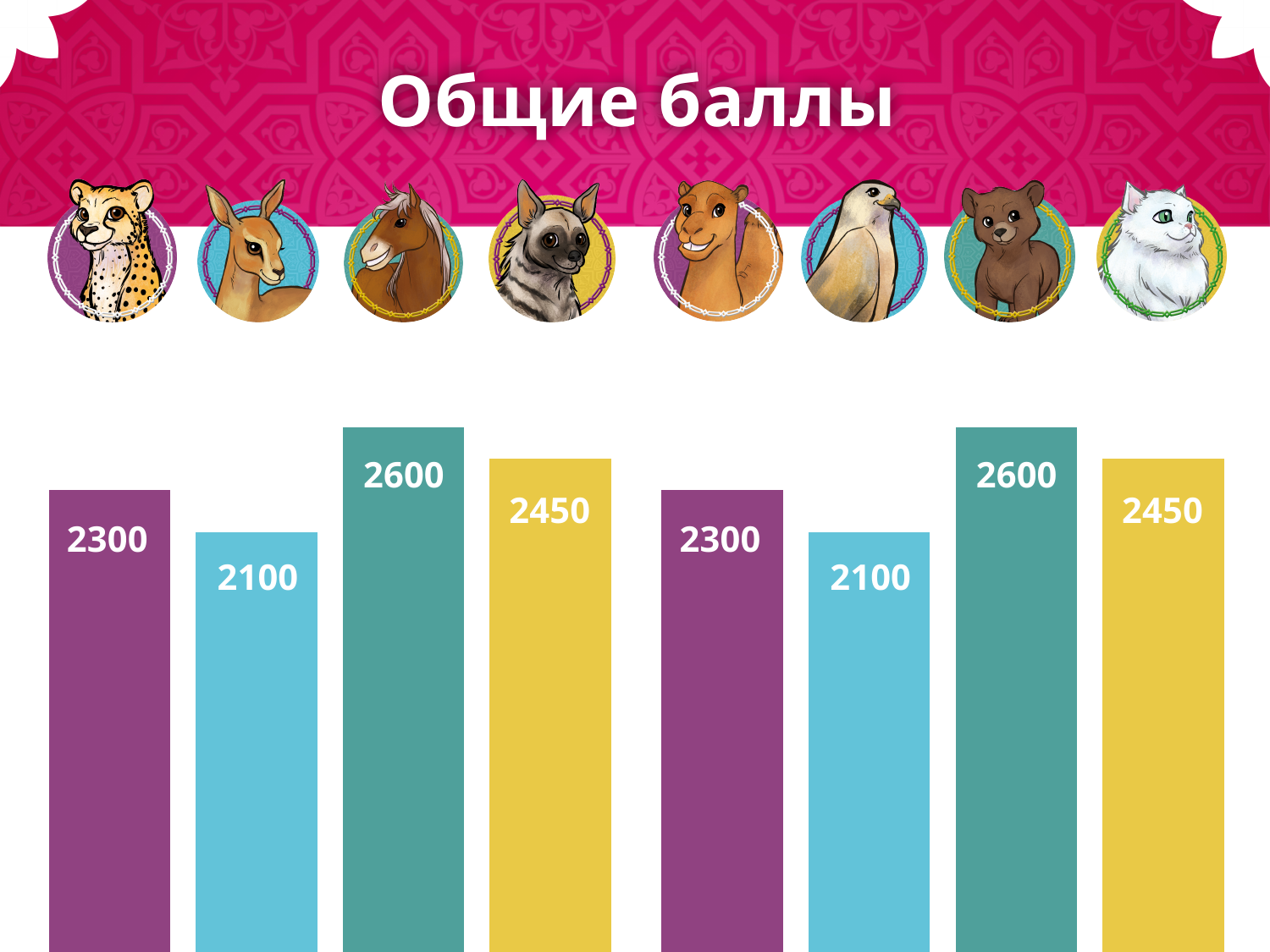
Which is larger, the value for the camel bar or the value for the falcon bar? camel What is the lowest value shown in the chart? 2100 What is the difference between the third bar (horse, 2600) and the second bar (gazelle, 2100)? 500 What is the title of the chart? Общие баллы What is the value of the fourth bar (under the hyena)? 2450 How many bars does the chart have? 8 What kind of chart is shown on the slide? bar chart What is the highest value shown in the chart? 2600 What is the value of the last bar (under the white cat)? 2450 What is the value of the third bar (under the horse)? 2600 What is the value of the first bar (under the cheetah)? 2300 What is the value of the second bar (under the gazelle)? 2100